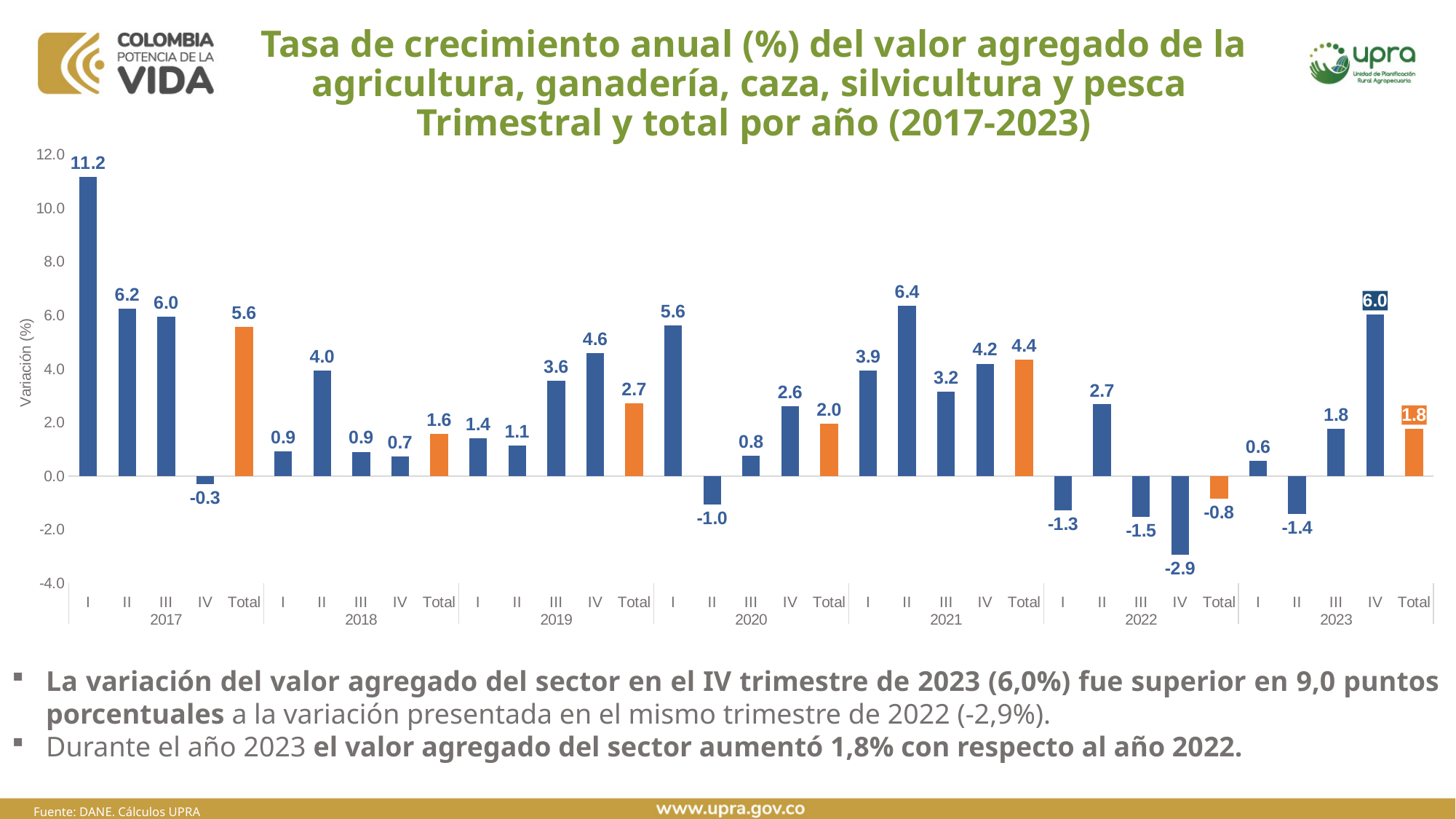
How many bars are plotted in the chart? 35 What is the annual total value for 2022? -0.8 Which is larger, the annual total for 2021 or the annual total for 2019? Total 2021 What is the difference between the annual totals for 2023 and 2022? 2.6 Which bar has the highest value in the chart? I 2017 What is the label of the vertical axis? Variación (%) What is the value for quarter I of 2017? 11.2 Which bar has the lowest value in the chart? IV 2022 What is the value for quarter IV of 2023? 6.0 What type of chart is shown on the slide? Bar chart What is the difference between the value for quarter IV of 2023 and quarter IV of 2022? 8.9 Which annual total is the highest among the years shown? 2017